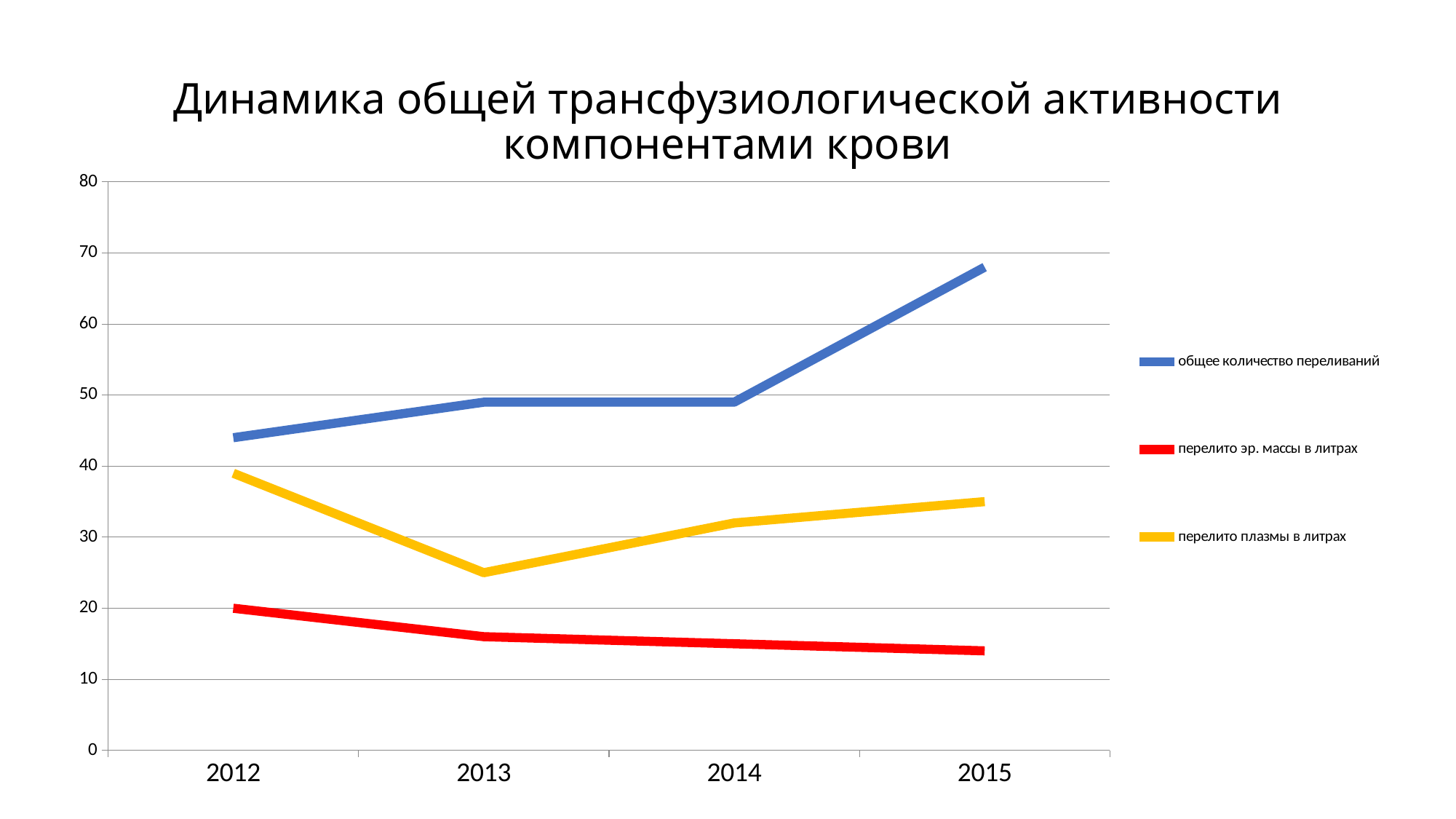
Is the value for 'перелито плазмы в литрах' in 2013 greater or less than 30? less What kind of chart is shown on the slide? line chart In which year is the value for 'перелито эр. массы в литрах' highest? 2012 In 2012, which is larger: 'перелито плазмы в литрах' or 'перелито эр. массы в литрах'? перелито плазмы в литрах What colour is the line for 'общее количество переливаний'? blue Is the value for 'общее количество переливаний' in 2015 greater or less than 60? greater Is the value for 'общее количество переливаний' in 2012 greater or less than 40? greater Does the value for 'перелито эр. массы в литрах' rise or fall from 2012 to 2015? fall How many series does the legend list? 3 In which year is the value for 'перелито плазмы в литрах' lowest? 2013 In which year is the value for 'общее количество переливаний' highest? 2015 How many years are shown on the x axis? 4